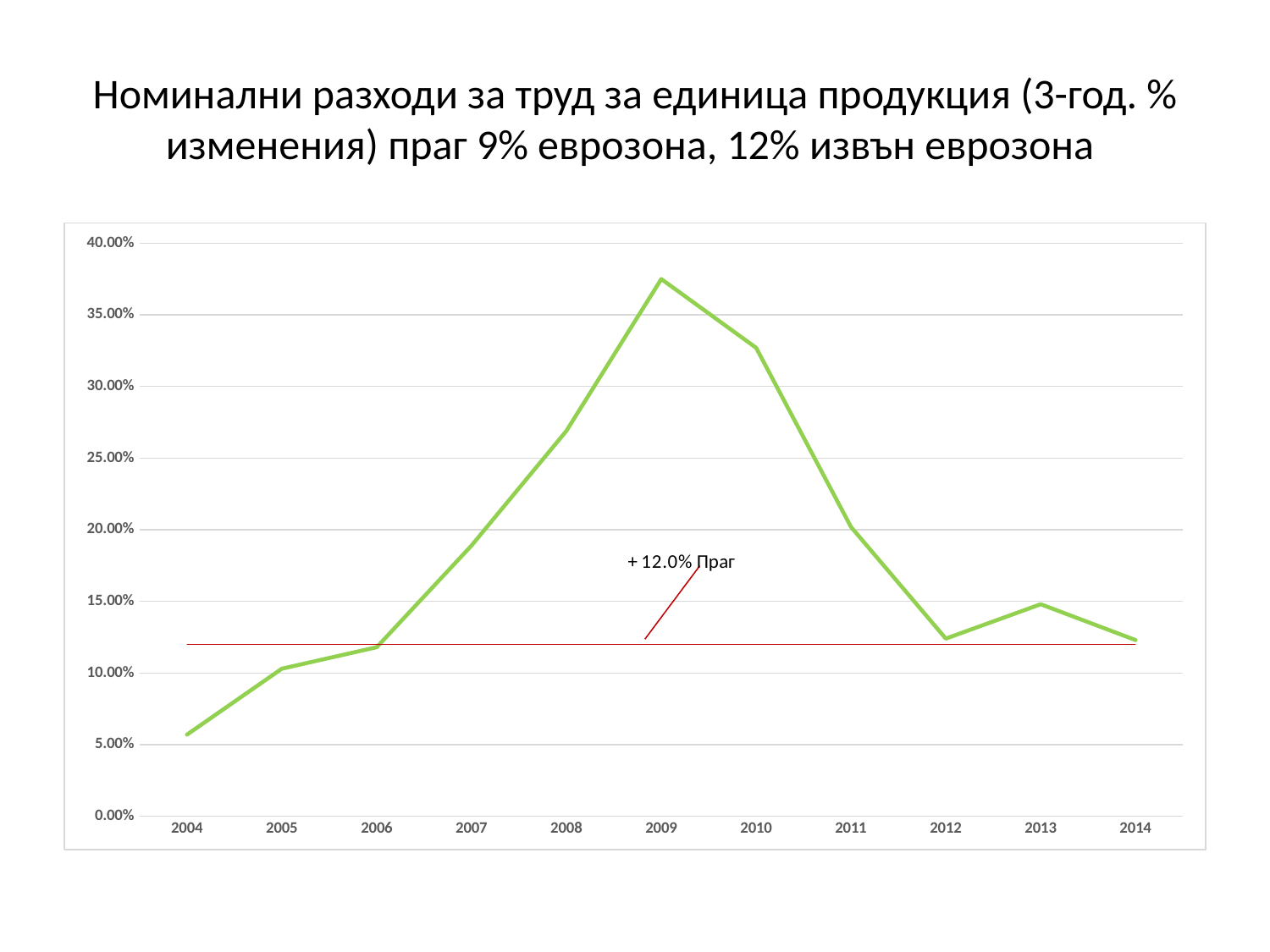
Is the value for 2009 greater or less than 35.00%? greater In which year does the line reach its highest value? 2009 Which year has the larger value, 2010 or 2012? 2010 Is the value for 2011 greater or less than 15.00%? greater Does the line rise or fall between 2009 and 2012? fall In which year does the line have its lowest value? 2004 Is the value for 2004 greater or less than 10.00%? less What kind of chart is shown on the slide? line chart Does the line rise or fall between 2004 and 2009? rise What threshold value is labelled by the horizontal line on the chart? + 12.0% Праг How many years are plotted along the x axis? 11